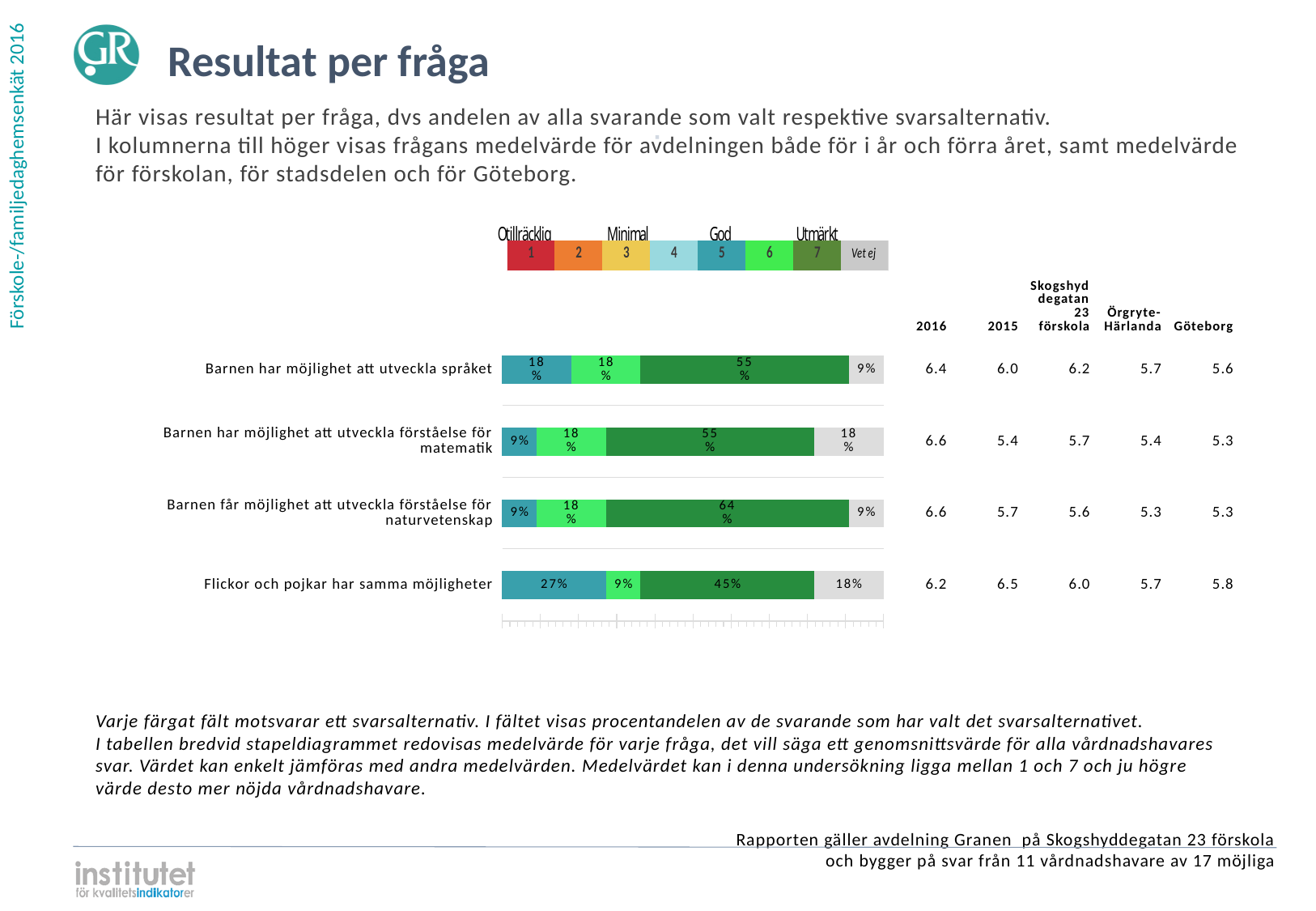
What percentage of respondents chose answer 5 (teal) for "Flickor och pojkar har samma möjligheter"? 27% How many answer categories does the legend above the chart list? 8 Which question has the smallest share of answer 7 (dark green)? Flickor och pojkar har samma möjligheter What is the "Vet ej" share for "Barnen har möjlighet att utveckla förståelse för matematik"? 18% How many percentage points larger is the answer-7 share for "naturvetenskap" than for "språket"? 9 percentage points What percentage chose answer 6 (light green) for "Barnen har möjlighet att utveckla språket"? 18% Which question has the largest share of answer 7 (dark green)? Barnen får möjlighet att utveckla förståelse för naturvetenskap How many questions (bars) are shown in the chart? 4 What percentage of respondents chose answer 7 (dark green) for "Barnen får möjlighet att utveckla förståelse för naturvetenskap"? 64% What type of chart is used to show the results per question? Stacked bar chart What is the total of the segments in the bar for "Flickor och pojkar har samma möjligheter"? 99% Which has a larger answer-5 (teal) share: "Flickor och pojkar har samma möjligheter" or "Barnen har möjlighet att utveckla språket"? Flickor och pojkar har samma möjligheter